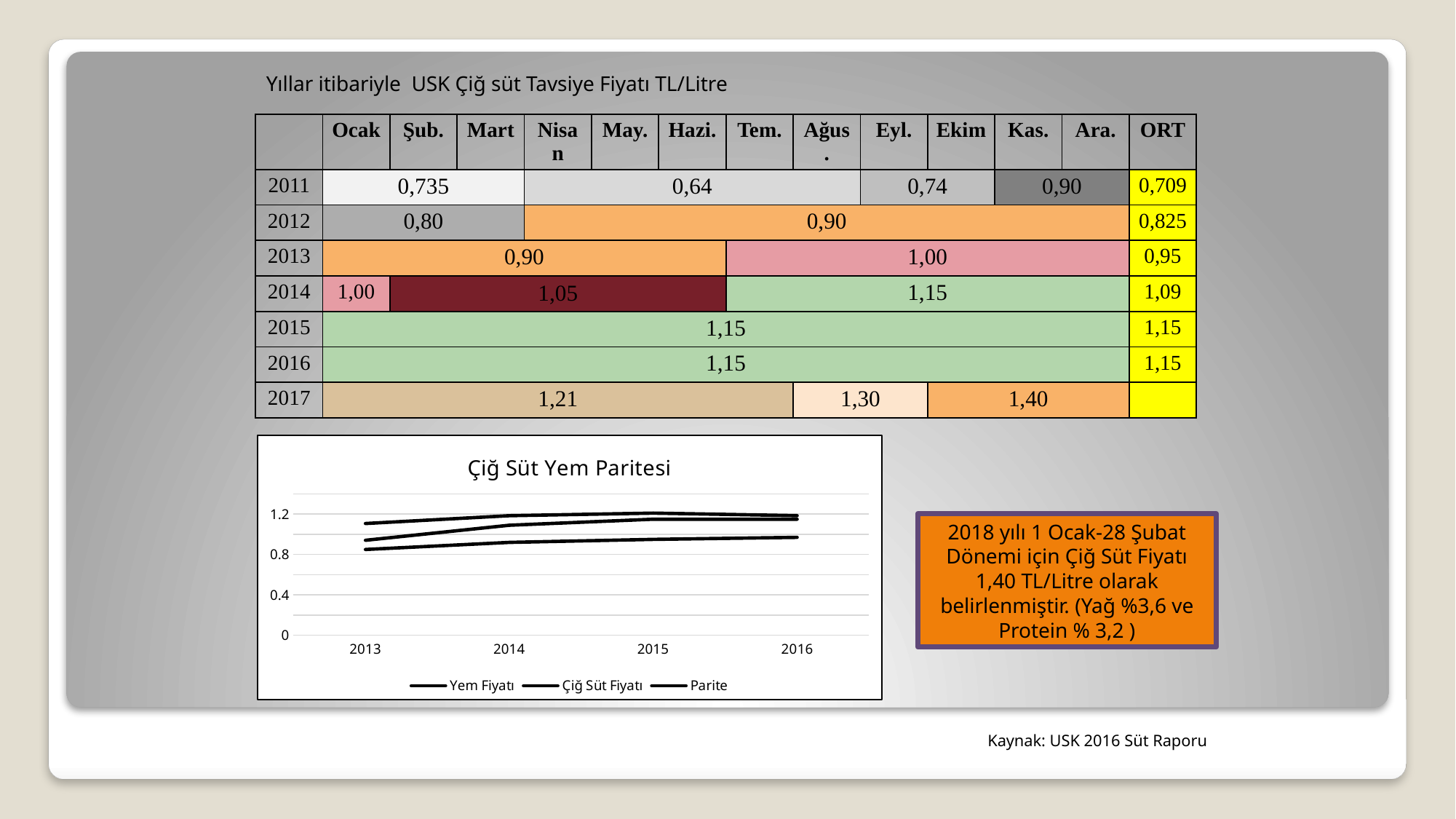
In the "Çiğ Süt Yem Paritesi" chart, do the lines generally rise or fall from 2013 to 2016? rise What is the first year shown on the x axis of the "Çiğ Süt Yem Paritesi" chart? 2013 How many series does the legend of the "Çiğ Süt Yem Paritesi" chart list? 3 In the "Çiğ Süt Yem Paritesi" chart, is the highest plotted value in 2016 greater or less than 0.8? greater Which series are listed in the legend of the "Çiğ Süt Yem Paritesi" chart? Yem Fiyatı, Çiğ Süt Fiyatı, Parite What kind of chart is "Çiğ Süt Yem Paritesi"? line chart What is the title of the line chart on the slide? Çiğ Süt Yem Paritesi What is the highest tick value on the y axis of the "Çiğ Süt Yem Paritesi" chart? 1.2 What is the last year shown on the x axis of the "Çiğ Süt Yem Paritesi" chart? 2016 In the "Çiğ Süt Yem Paritesi" chart, is the lowest plotted value in 2013 greater or less than 0.4? greater How many years are shown on the x axis of the "Çiğ Süt Yem Paritesi" chart? 4